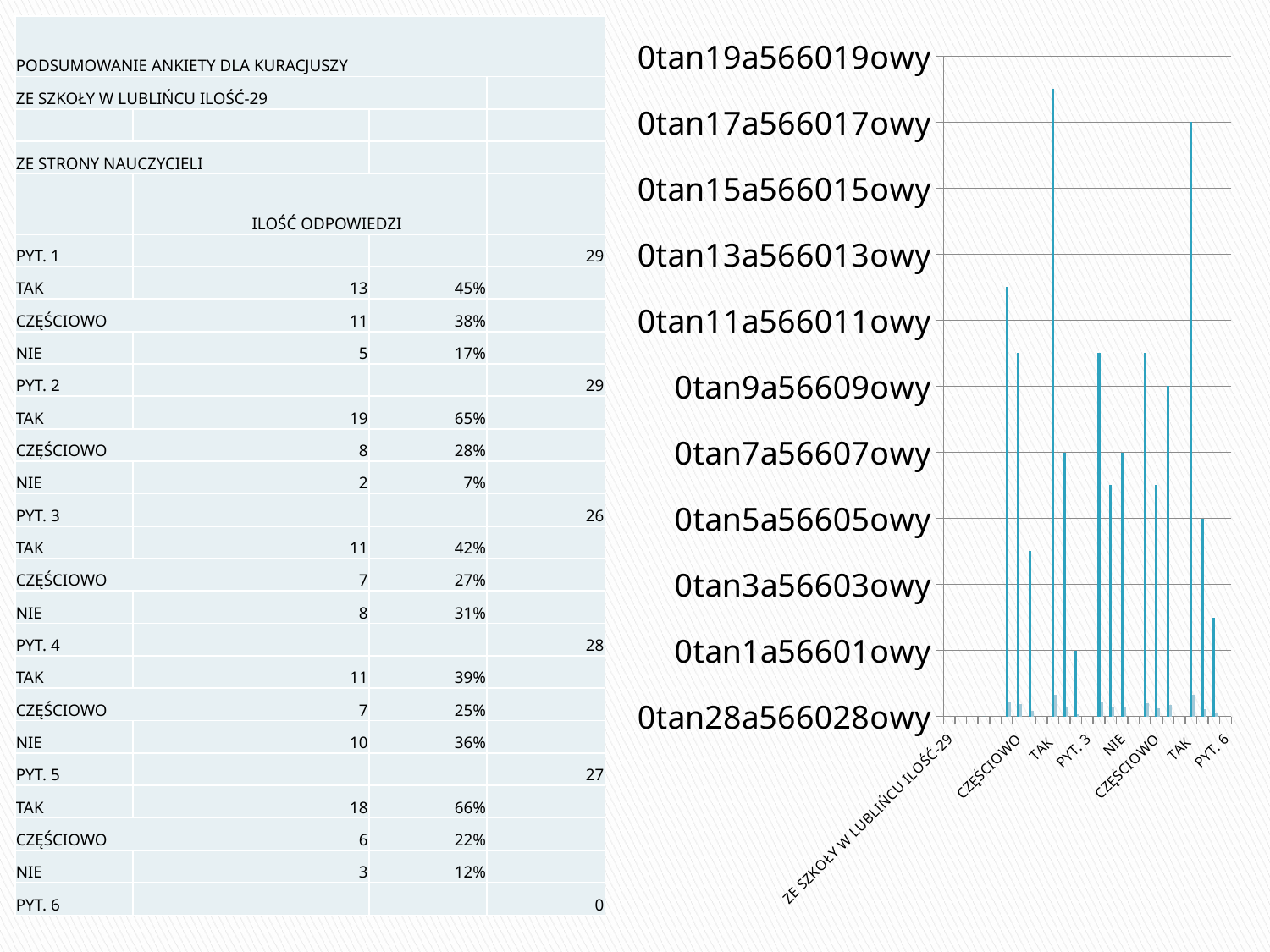
What kind of chart is shown on the right side of the slide? bar chart Do the bar heights rise steadily, fall steadily, or fluctuate along the x axis? fluctuate Is the bar at the first TAK label taller or shorter than the bar at the second TAK label? taller What is the first category label shown on the x axis of the chart? ZE SZKOŁY W LUBLIŃCU ILOŚĆ-29 Which labelled category on the x axis has the tallest bar in the chart? TAK (the first TAK label from the left) What is the last category label shown on the x axis of the chart? PYT. 6